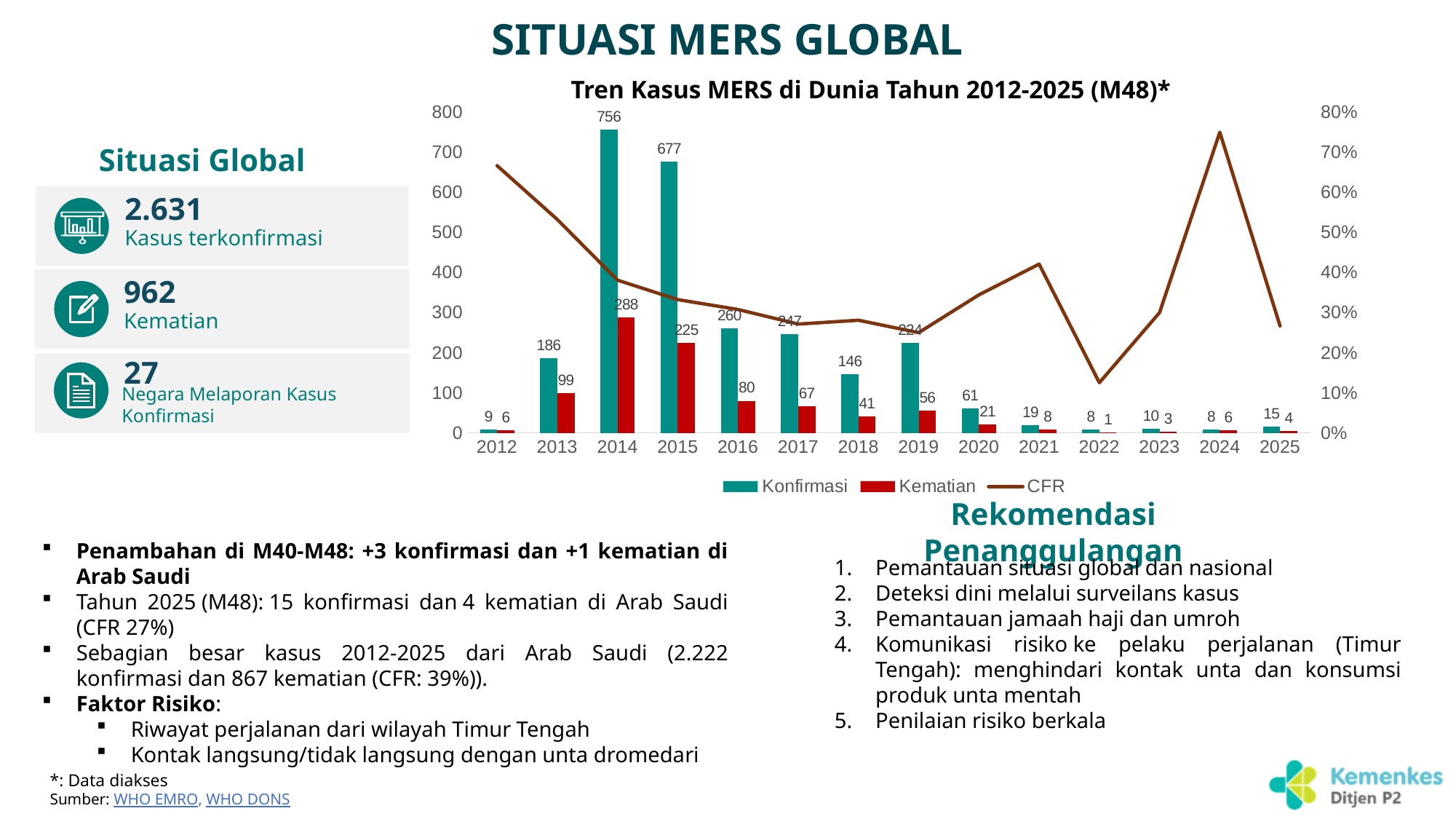
What is the title of the chart? Tren Kasus MERS di Dunia Tahun 2012-2025 (M48)* Is the CFR value for 2022 greater or less than 20%? less What is the Konfirmasi value for 2014? 756 What is the Kematian value for 2015? 225 Which year has the highest Konfirmasi value? 2014 How many series does the chart legend list? 3 Which year has the lowest Kematian value? 2022 Which is larger, the Kematian value for 2013 or for 2016? 2013 What is the difference between the Konfirmasi values for 2014 and 2015? 79 How many years are shown on the x axis of the chart? 14 What kind of chart is used to show the Konfirmasi and Kematian series? Bar chart Is the CFR value for 2024 greater or less than 70%? greater